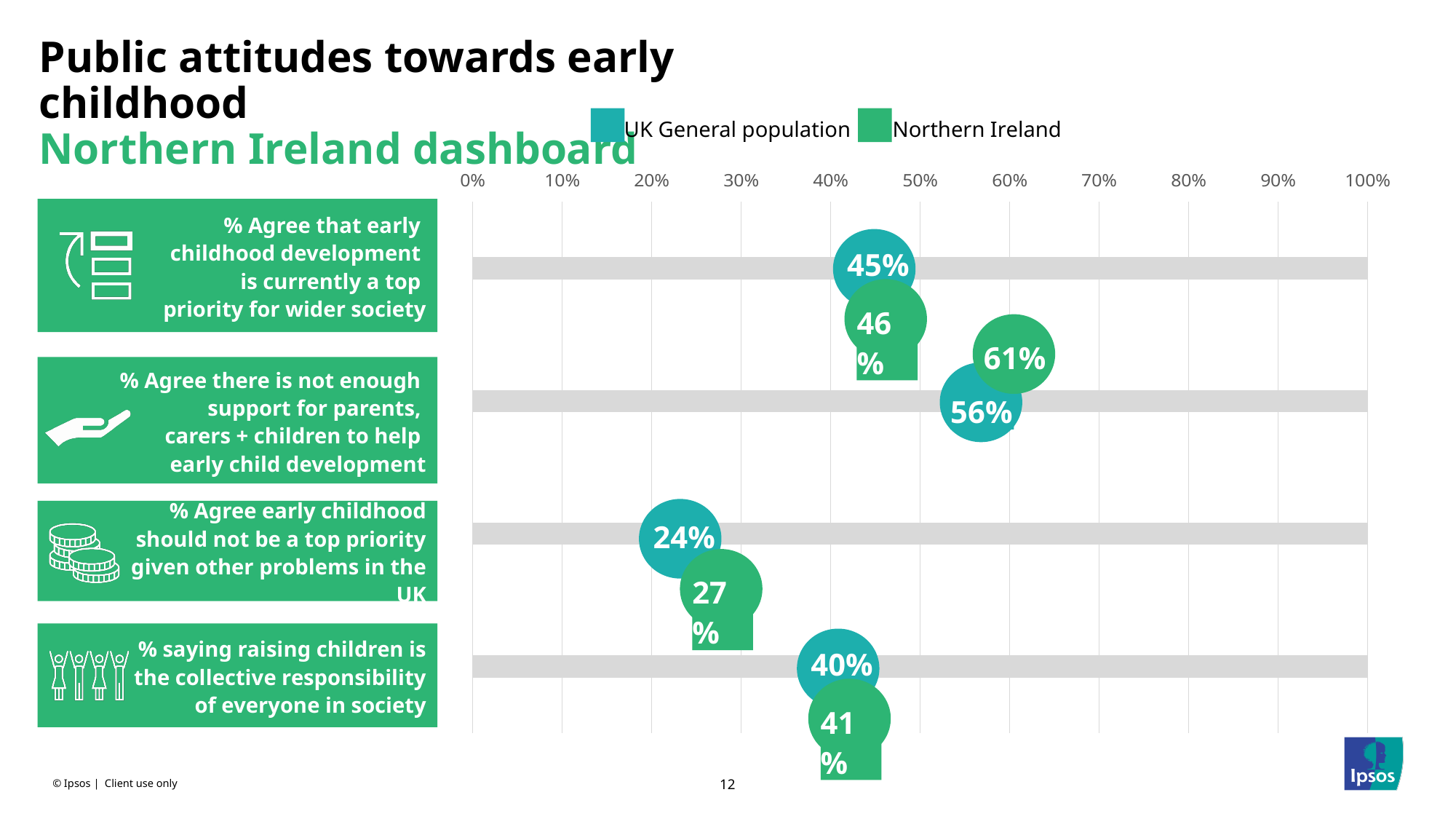
What percentage of the UK General population say raising children is the collective responsibility of everyone in society? 40% What percentage of Northern Ireland respondents agree that early childhood development is currently a top priority for wider society? 46% What percentage of Northern Ireland respondents agree early childhood should not be a top priority given other problems in the UK? 27% How many statements are plotted on the chart? 4 What is the UK General population value for agreeing there is not enough support for parents, carers and children to help early child development? 56% For agreeing early childhood should not be a top priority given other problems in the UK, which is larger: the UK General population value or the Northern Ireland value? Northern Ireland What is the difference between the Northern Ireland and UK General population values for agreeing there is not enough support for parents, carers and children? 5 percentage points How many series does the legend list? 2 Which statement has the lowest UK General population value? % Agree early childhood should not be a top priority given other problems in the UK What is the Northern Ireland value for agreeing there is not enough support for parents, carers and children to help early child development? 61% What percentage of the UK General population agree that early childhood development is currently a top priority for wider society? 45% Which statement has the highest Northern Ireland value? % Agree there is not enough support for parents, carers + children to help early child development